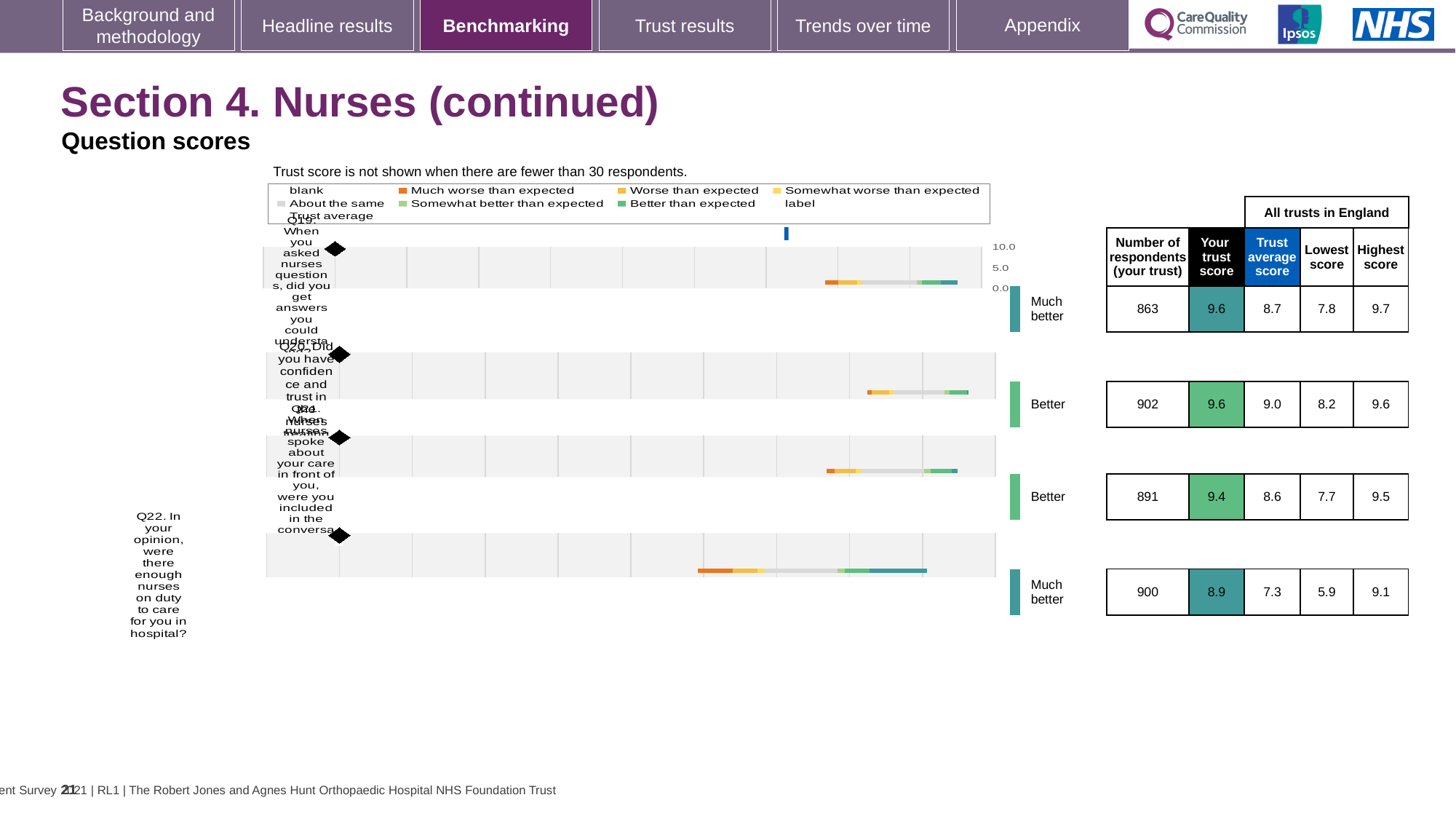
What is the 'Your trust score' for Q19 (When you asked nurses questions, did you get answers you could understand)? 9.6 How many respondents from your trust answered Q20 (Did you have confidence and trust in the nurses)? 902 What is the difference between the highest and lowest scores in England for Q19? 1.9 How many questions (categories) are plotted in the chart? 4 What is the lowest score among all trusts in England for Q22? 5.9 For Q21, which is larger: your trust score or the trust average score? Your trust score What is the highest score among all trusts in England for Q21? 9.5 What is the trust average score for Q22 (were there enough nurses on duty to care for you in hospital)? 7.3 What kind of chart is used to show the question scores on this slide? Bar chart What is the difference between your trust score and the trust average score for Q22? 1.6 Which question has the lowest 'Your trust score'? Q22 What benchmark rating label is shown next to Q22? Much better